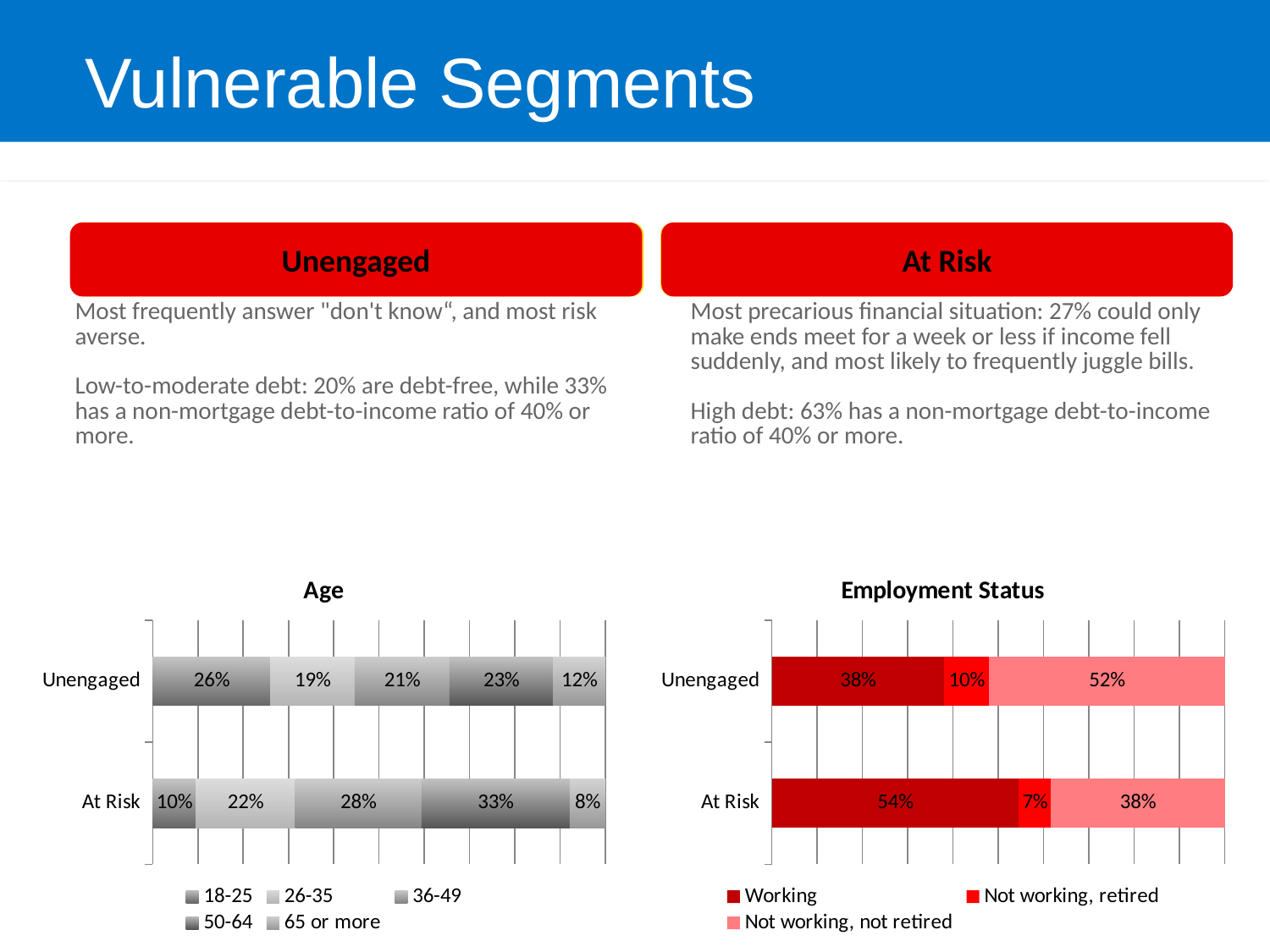
In the Employment Status chart, what percentage of the Unengaged segment is not working, not retired? 52% How many segments (categories) are shown in the Employment Status chart? 2 In the Employment Status chart, what percentage of the At Risk segment is working? 54% In the Employment Status chart, which segment has the larger share of working people, Unengaged or At Risk? At Risk In the Employment Status chart, what is the difference between the 'Not working, retired' shares of Unengaged and At Risk? 3% What type of chart is the Employment Status chart? Stacked bar chart In the Age chart, which age group has the largest share of the Unengaged segment? 18-25 In the Age chart, how many age groups does the legend list? 5 In the Age chart, what percentage of the Unengaged segment is aged 18-25? 26% In the Age chart, what percentage of the At Risk segment is aged 50-64? 33% In the Age chart, which age group has the smallest share of the At Risk segment? 65 or more In the Age chart, what is the difference between the 36-49 shares of At Risk and Unengaged? 7%